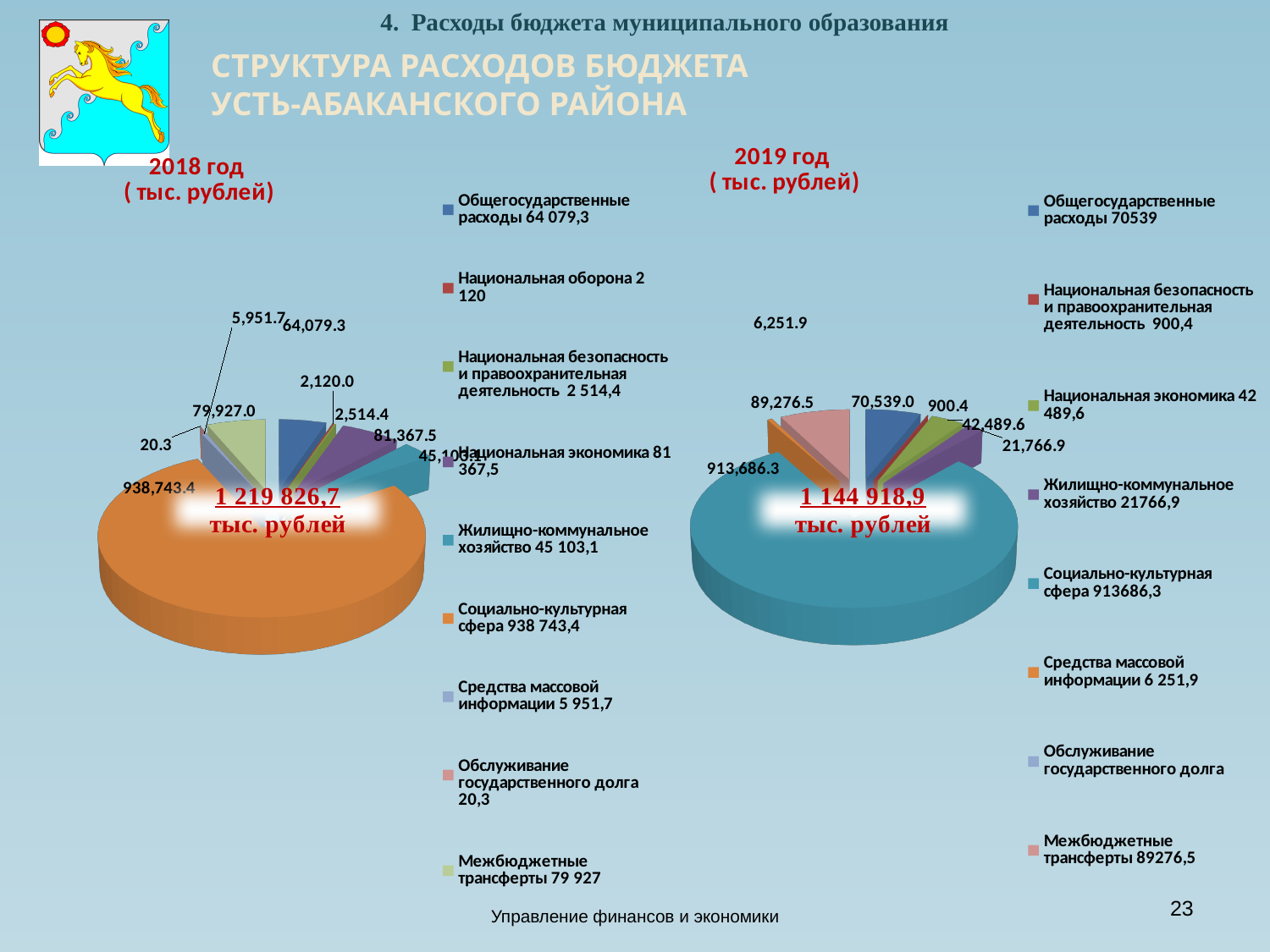
In the 2019 год chart, what is the value for Общегосударственные расходы? 70,539.0 What total is printed on the 2019 год chart? 1 144 918,9 тыс. рублей What total is printed on the 2018 год chart? 1 219 826,7 тыс. рублей How many categories does the legend of the 2018 год chart list? 9 In the 2018 год chart, which category has the largest value? Социально-культурная сфера In the 2019 год chart, what is the value for Межбюджетные трансферты? 89,276.5 What type of chart is used for the 2018 год budget expenditure structure? pie chart In the 2019 год chart, which is larger: Национальная экономика or Жилищно-коммунальное хозяйство? Национальная экономика In the 2018 год chart, which category has the smallest value? Обслуживание государственного долга In the 2018 год chart, what is the value for Национальная экономика? 81,367.5 What is the difference between Общегосударственные расходы in the 2019 год chart and in the 2018 год chart? 6,459.7 In the 2018 год chart, what is the value for Социально-культурная сфера? 938,743.4